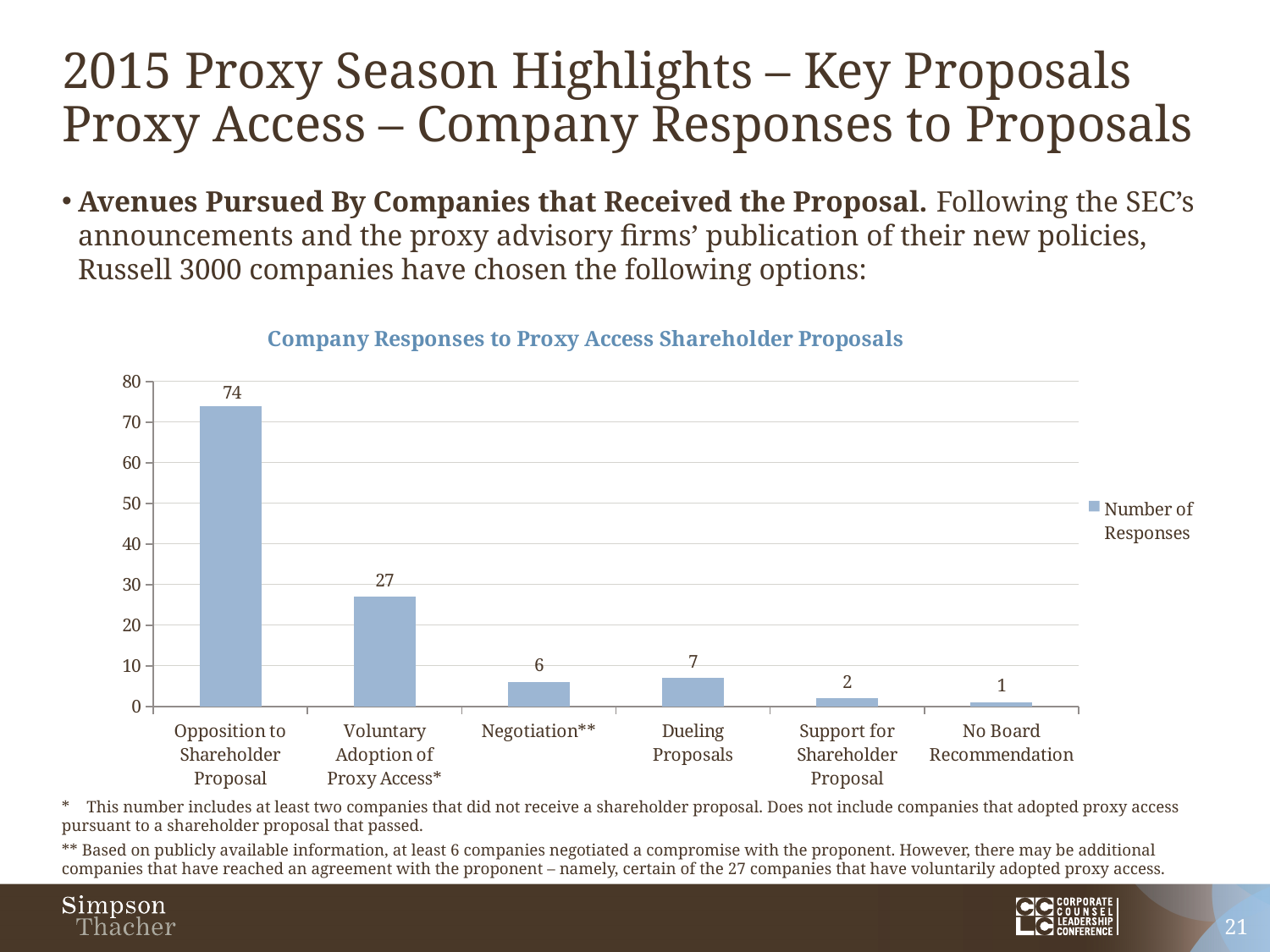
What is the difference between the number of responses for Opposition to Shareholder Proposal and Voluntary Adoption of Proxy Access*? 47 What is the number of responses for No Board Recommendation? 1 Which has more responses, Negotiation** or Dueling Proposals? Dueling Proposals What is the number of responses for Voluntary Adoption of Proxy Access*? 27 What kind of chart is shown on the slide? Bar chart What is the number of responses for Opposition to Shareholder Proposal? 74 Which category has the highest number of responses? Opposition to Shareholder Proposal What is the title of the chart? Company Responses to Proxy Access Shareholder Proposals How many categories are shown on the x axis of the chart? 6 Which category has the lowest number of responses? No Board Recommendation How many series does the legend list? 1 What is the number of responses for Dueling Proposals? 7